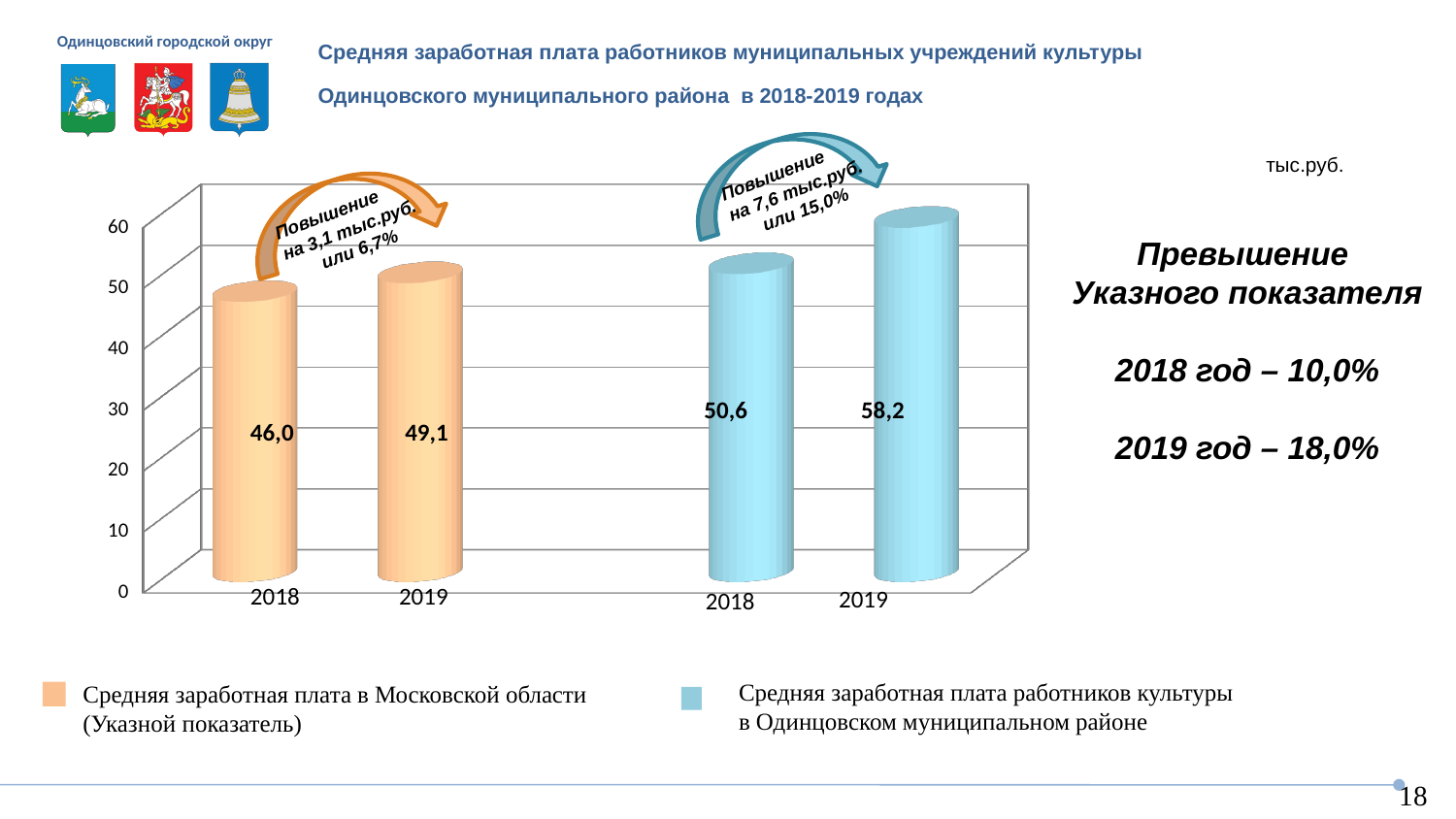
What is the average salary of culture workers in the Odintsovo municipal district in 2019? 58,2 What kind of chart is shown on the slide? Bar chart Which bar shows the highest value on the chart? Culture workers in Odintsovo district, 2019 (58,2) Which bar shows the lowest value on the chart? Moscow region average, 2018 (46,0) What is the average salary in the Moscow region (Указной показатель) in 2018? 46,0 How many series does the legend list? 2 What unit of measurement is indicated for the chart values? тыс.руб. Which is larger in 2019: the Moscow region average salary or the salary of culture workers in the Odintsovo district? Culture workers in the Odintsovo district (58,2) What is the average salary of culture workers in the Odintsovo municipal district in 2018? 50,6 By how much did the Moscow region average salary increase from 2018 to 2019? 3,1 By how much did the average salary of culture workers in the Odintsovo district increase from 2018 to 2019? 7,6 What is the average salary in the Moscow region (Указной показатель) in 2019? 49,1